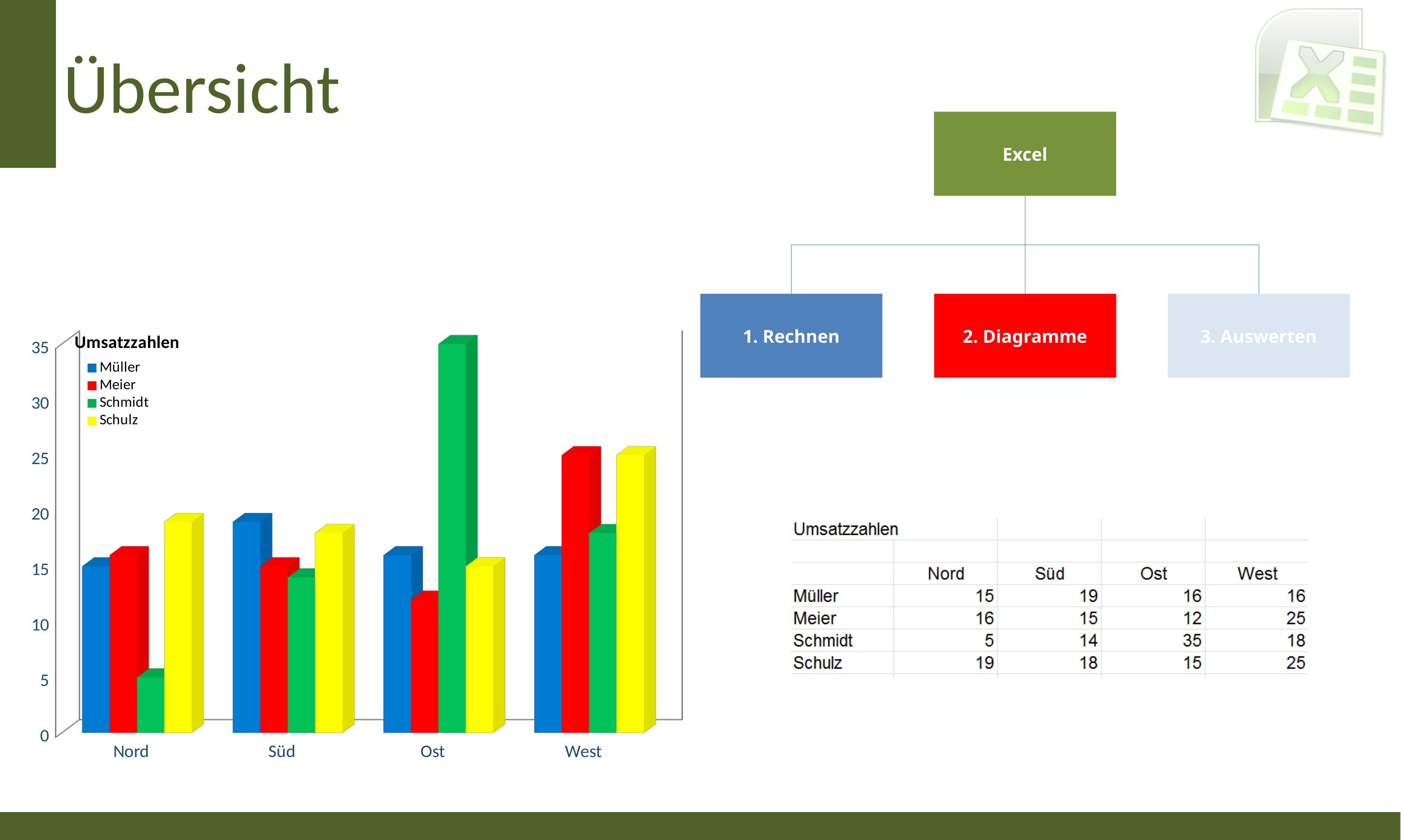
What is the value for Schmidt in Ost? 35 How many categories are shown on the x axis of the chart? 4 What is the difference between Meier's value in West and Meier's value in Ost? 13 What is the title of the chart? Umsatzzahlen How many series does the chart legend list? 4 What kind of chart is shown on the slide? bar chart Which is larger: Müller in Süd or Müller in Nord? Müller in Süd What is the value for Schulz in Nord? 19 Is the value for Schmidt in Ost greater or less than 30? greater Which series has the highest value in Ost? Schmidt Which series has the lowest value in Nord? Schmidt Which colour represents the Schulz series in the chart? yellow